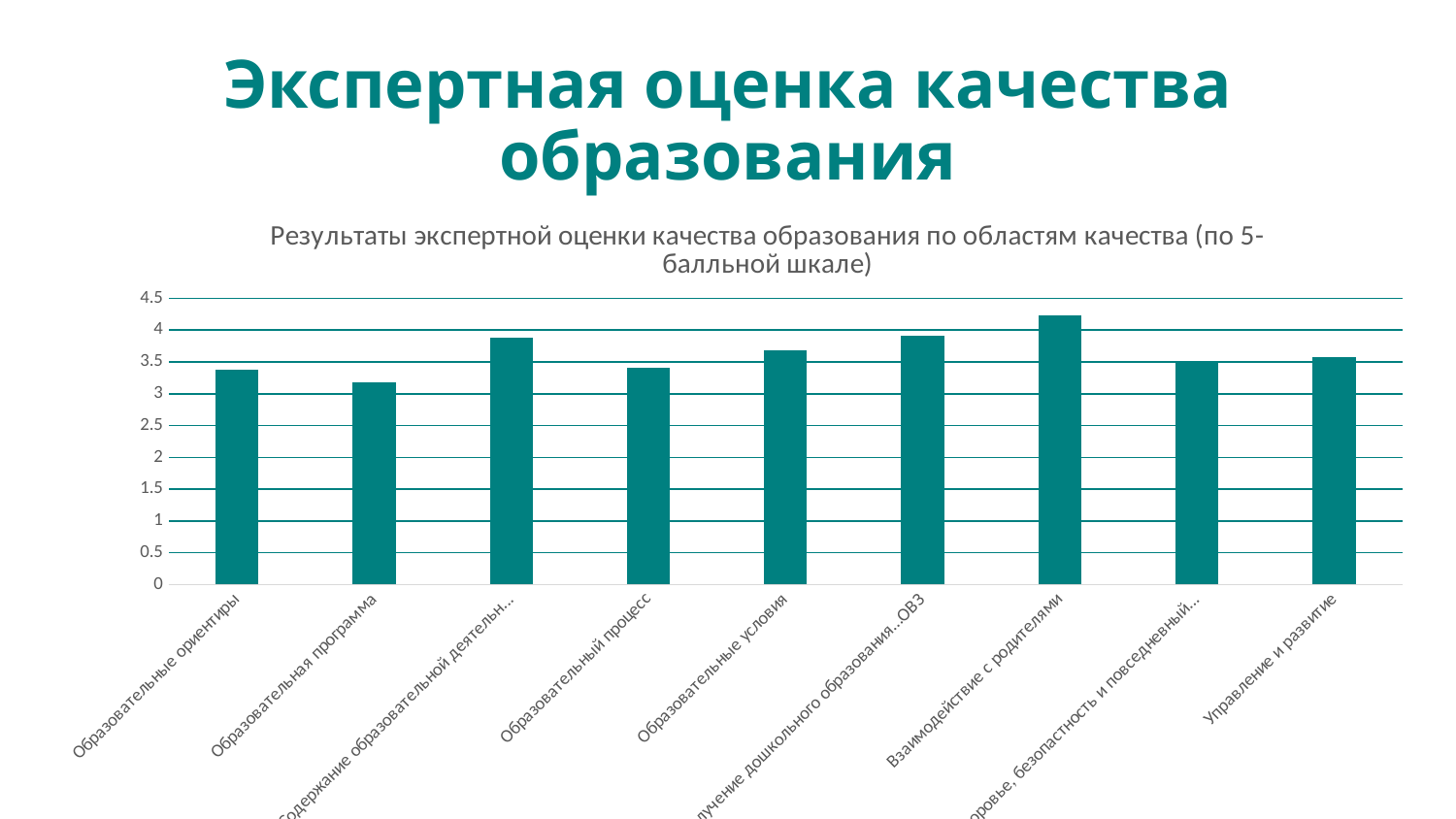
Is the value for Управление и развитие greater or less than 3? greater How many categories (bars) are plotted in the chart? 9 Which is larger: the value for Образовательные условия or the value for Образовательный процесс? Образовательные условия Which is larger: the value for Взаимодействие с родителями or the value for Образовательная программа? Взаимодействие с родителями Which category has the lowest value in the chart? Образовательная программа Which category has the highest value in the chart? Взаимодействие с родителями Is the value for Образовательные условия greater or less than 3.5? greater Is the value for Образовательные ориентиры greater or less than 3? greater What is the title of the chart? Результаты экспертной оценки качества образования по областям качества (по 5-балльной шкале) What kind of chart is shown on the slide? bar chart